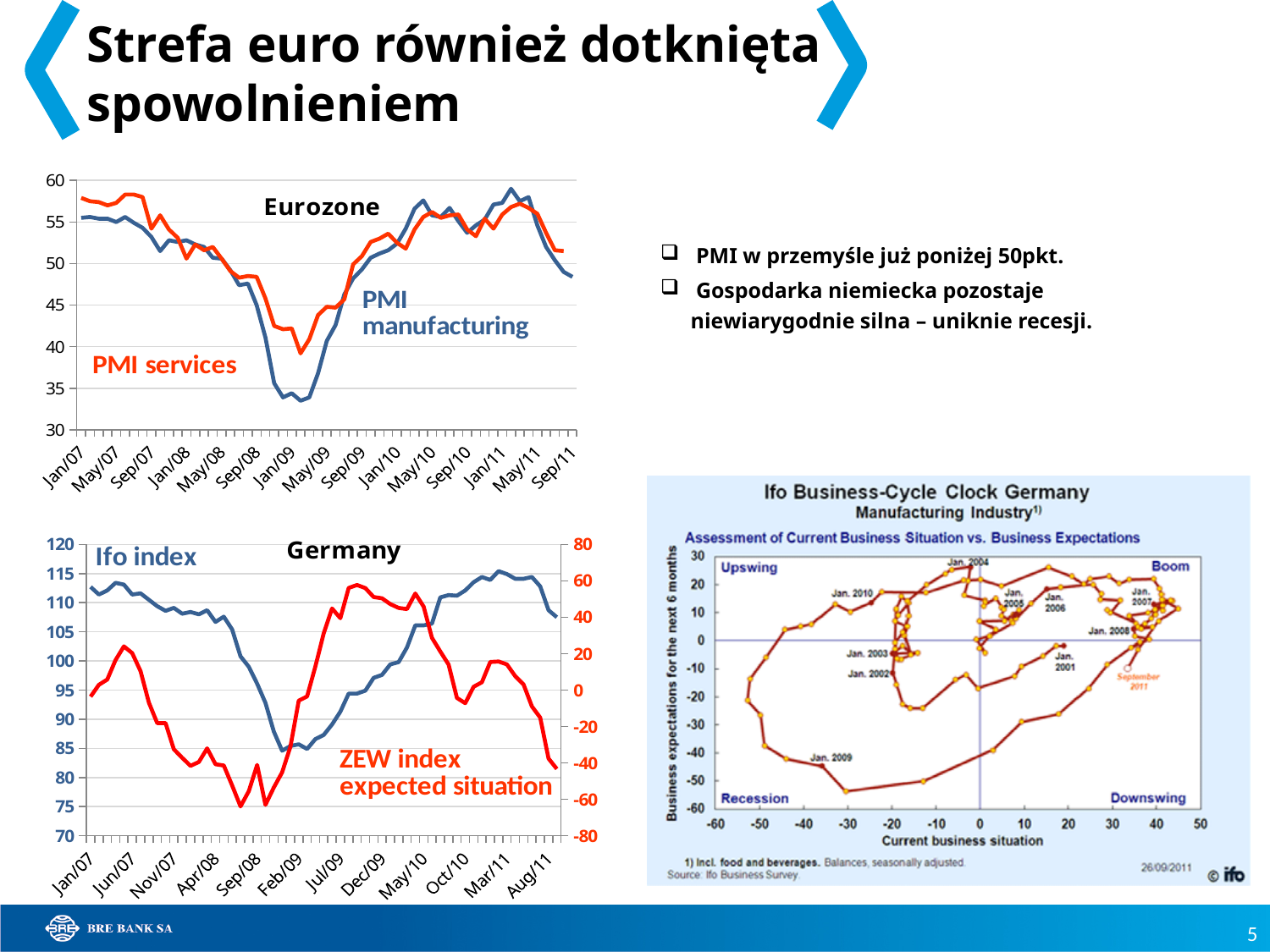
What kind of chart is the Eurozone chart at the top left of the slide? line chart On the Germany chart, does the ZEW index expected situation rise or fall between Mar/11 and Aug/11? fall On the Eurozone chart, is the value of PMI manufacturing in Sep/11 greater or less than 50? less How many series are plotted on the Eurozone chart? 2 On the Eurozone chart, is the value of PMI manufacturing in Jan/09 greater or less than 40? less On the Eurozone chart, is the value of PMI services in Jan/07 greater or less than 55? greater On the Germany chart, which two series are plotted? Ifo index and ZEW index expected situation On the Ifo Business-Cycle Clock Germany chart, in which quadrant does the Jan. 2009 point lie? Recession On the Eurozone chart, which series reaches the lowest value over the period shown? PMI manufacturing On the Eurozone chart, do the PMI series rise or fall between May/11 and Sep/11? fall